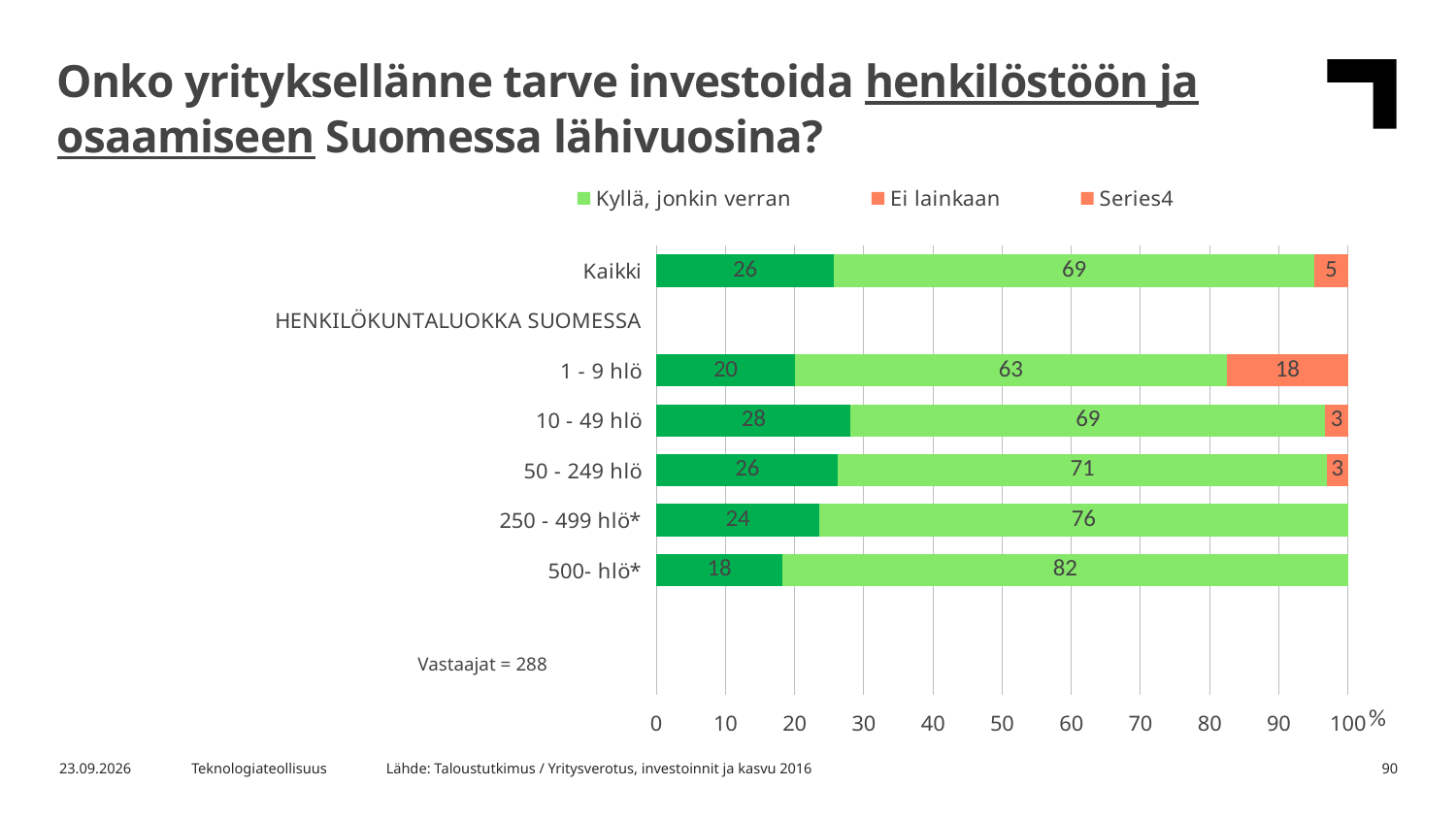
What is the total of the stacked bar for the '1 - 9 hlö' category? 101 What is the value of the 'Ei lainkaan' segment for the '1 - 9 hlö' category? 18 What is the value of the 'Kyllä, jonkin verran' segment for the '500- hlö*' category? 82 Which is larger: the 'Ei lainkaan' value for 'Kaikki' or for '50 - 249 hlö'? Kaikki Which category has the highest 'Kyllä, jonkin verran' value? 500- hlö* Which category has the lowest 'Kyllä, jonkin verran' value? 1 - 9 hlö What is the value of the dark green (first) segment for the '10 - 49 hlö' category? 28 What kind of chart is shown on the slide? Stacked bar chart What is the value of the 'Kyllä, jonkin verran' segment for 'Kaikki'? 69 Which category has the highest 'Ei lainkaan' value? 1 - 9 hlö What is the difference between the 'Kyllä, jonkin verran' values for '500- hlö*' and '1 - 9 hlö'? 19 How many series does the legend list? 3